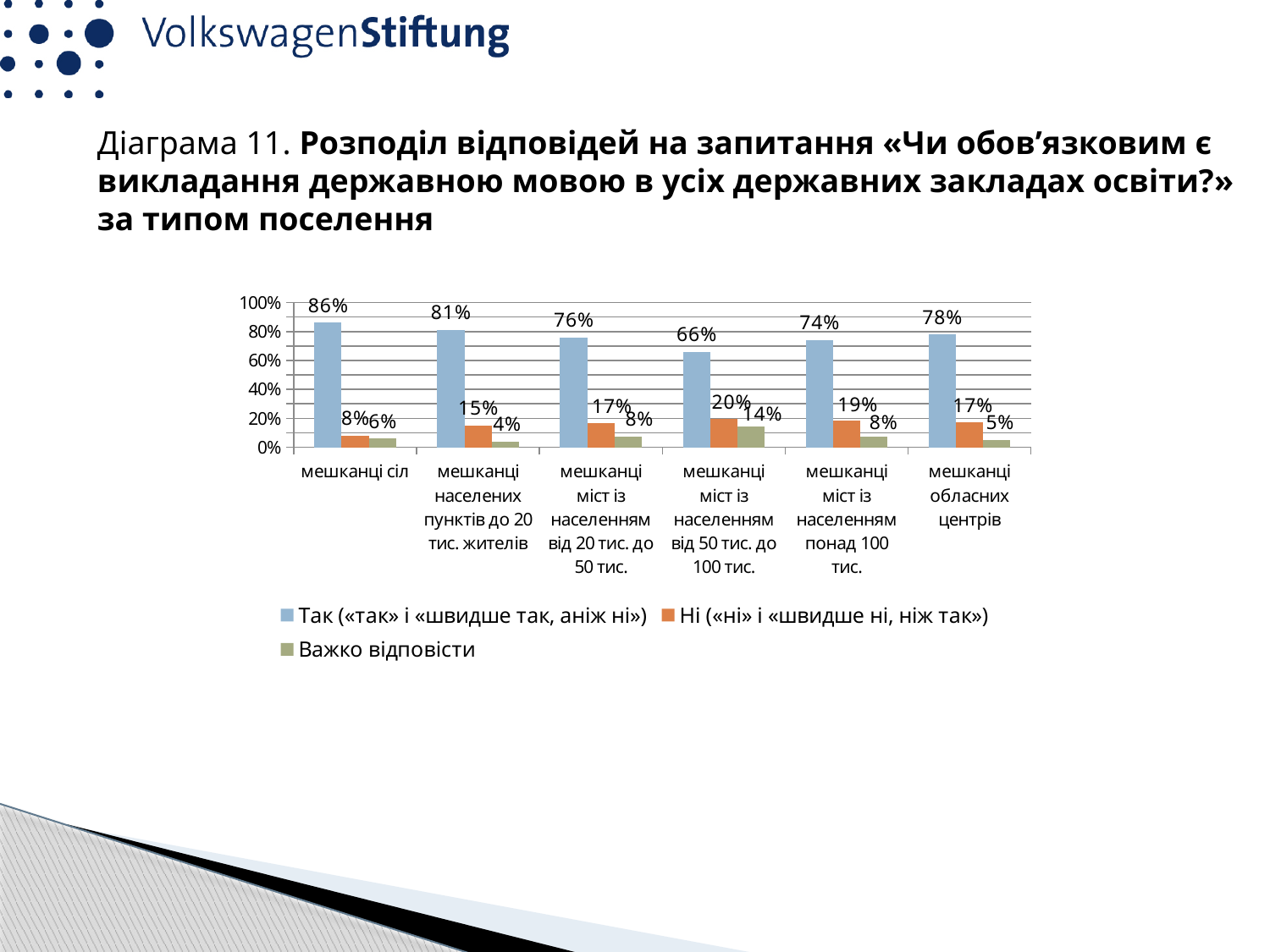
Is the «Так» value for residents of cities with a population of 50 to 100 thousand greater or less than 80%? less Which settlement type has the lowest value for the «Так» series? мешканці міст із населенням від 50 тис. до 100 тис. Which settlement type has the highest value for the «Важко відповісти» series? мешканці міст із населенням від 50 тис. до 100 тис. What is the value of the «Ні» series for residents of cities with a population of 50 to 100 thousand (мешканці міст із населенням від 50 тис. до 100 тис.)? 20% What share of residents of regional centres (мешканці обласних центрів) answered «Важко відповісти»? 5% What is the difference between the «Так» values for village residents (мешканці сіл) and residents of regional centres (мешканці обласних центрів)? 8 percentage points What percentage of village residents (мешканці сіл) answered «Так» (yes)? 86% How many settlement types (categories) are shown on the x axis? 6 Which settlement type has the highest value for the «Так» series? мешканці сіл How many series does the legend list? 3 Which is larger: the «Ні» value for residents of cities over 100 thousand (понад 100 тис.) or for residents of settlements up to 20 thousand (до 20 тис. жителів)? мешканці міст із населенням понад 100 тис. What type of chart is shown on the slide? bar chart